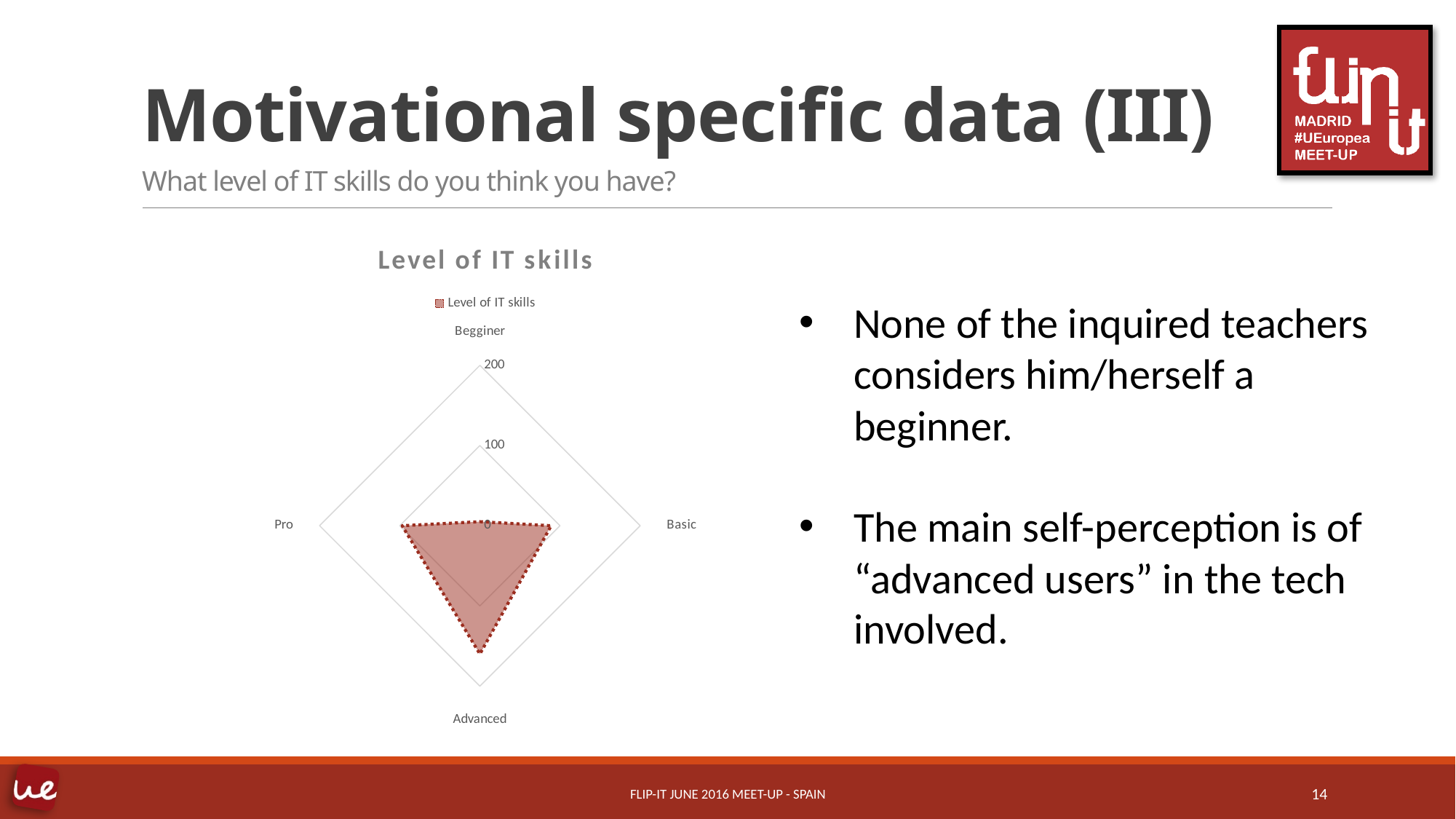
Which category has the highest value in the chart? Advanced Is the value for Basic greater or less than 100? less Is the value for Advanced greater or less than 200? less What is the title of the chart? Level of IT skills How many series does the chart legend list? 1 How many categories are plotted on the radar chart? 4 Is the value for Advanced greater or less than 100? greater Which category has the lowest value in the chart? Begginer Which has a larger value, Advanced or Basic? Advanced What kind of chart is shown on the slide? Radar chart